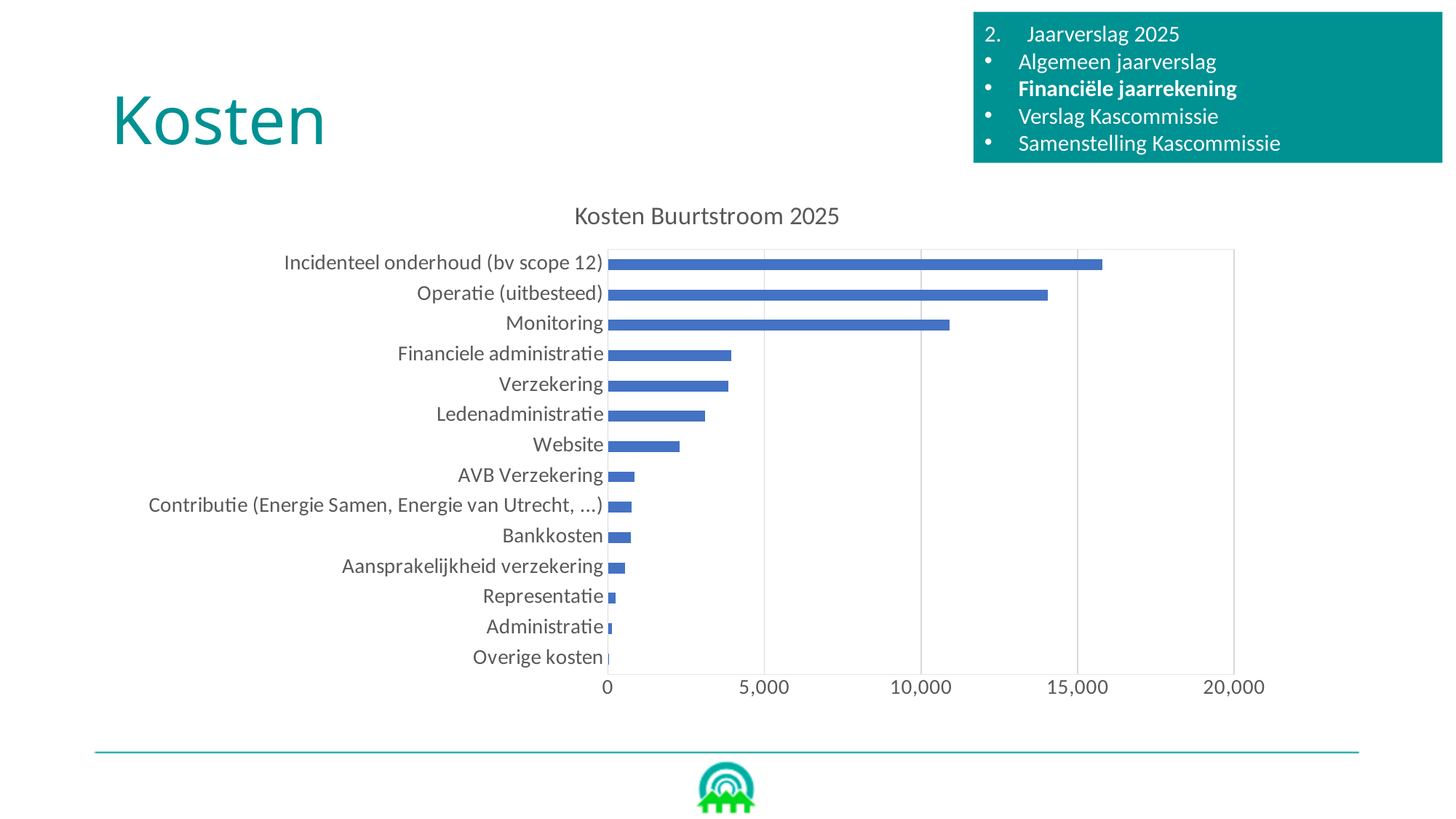
Which category has the lowest cost? Overige kosten Is the value for Operatie (uitbesteed) greater or less than 15,000? less How many cost categories are shown in the chart? 14 What is the highest value shown on the horizontal axis? 20,000 Which is larger, the value for Operatie (uitbesteed) or the value for Ledenadministratie? Operatie (uitbesteed) Is the value for Financiele administratie greater or less than 5,000? less What type of chart is shown on the slide? bar chart Which is larger, the value for Monitoring or the value for Website? Monitoring Which category has the highest cost? Incidenteel onderhoud (bv scope 12) Is the value for Incidenteel onderhoud (bv scope 12) greater or less than 15,000? greater What is the title of the chart? Kosten Buurtstroom 2025